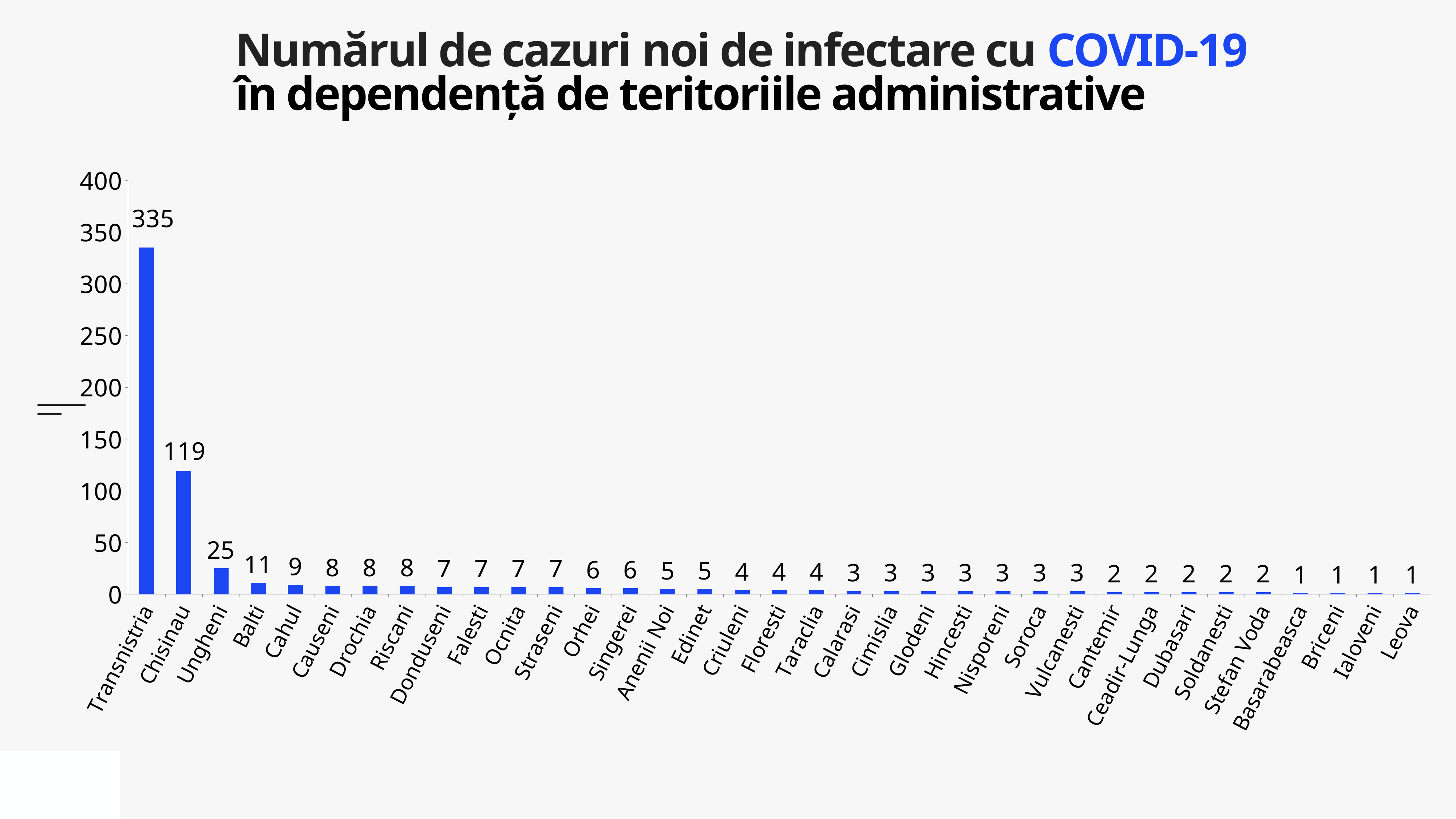
What is the value for Transnistria? 335 How many categories are shown on the x axis? 35 What is the difference between the values for Transnistria and Chisinau? 216 What is the value for Orhei? 6 What is the value for Balti? 11 Which is larger, the value for Cahul or the value for Edinet? Cahul What is the value for Chisinau? 119 Which category has the highest value? Transnistria Is the value for Chisinau greater or less than 100? greater What is the value for Ungheni? 25 Do the values rise or fall from left to right along the x axis? fall What kind of chart is shown on the slide? bar chart